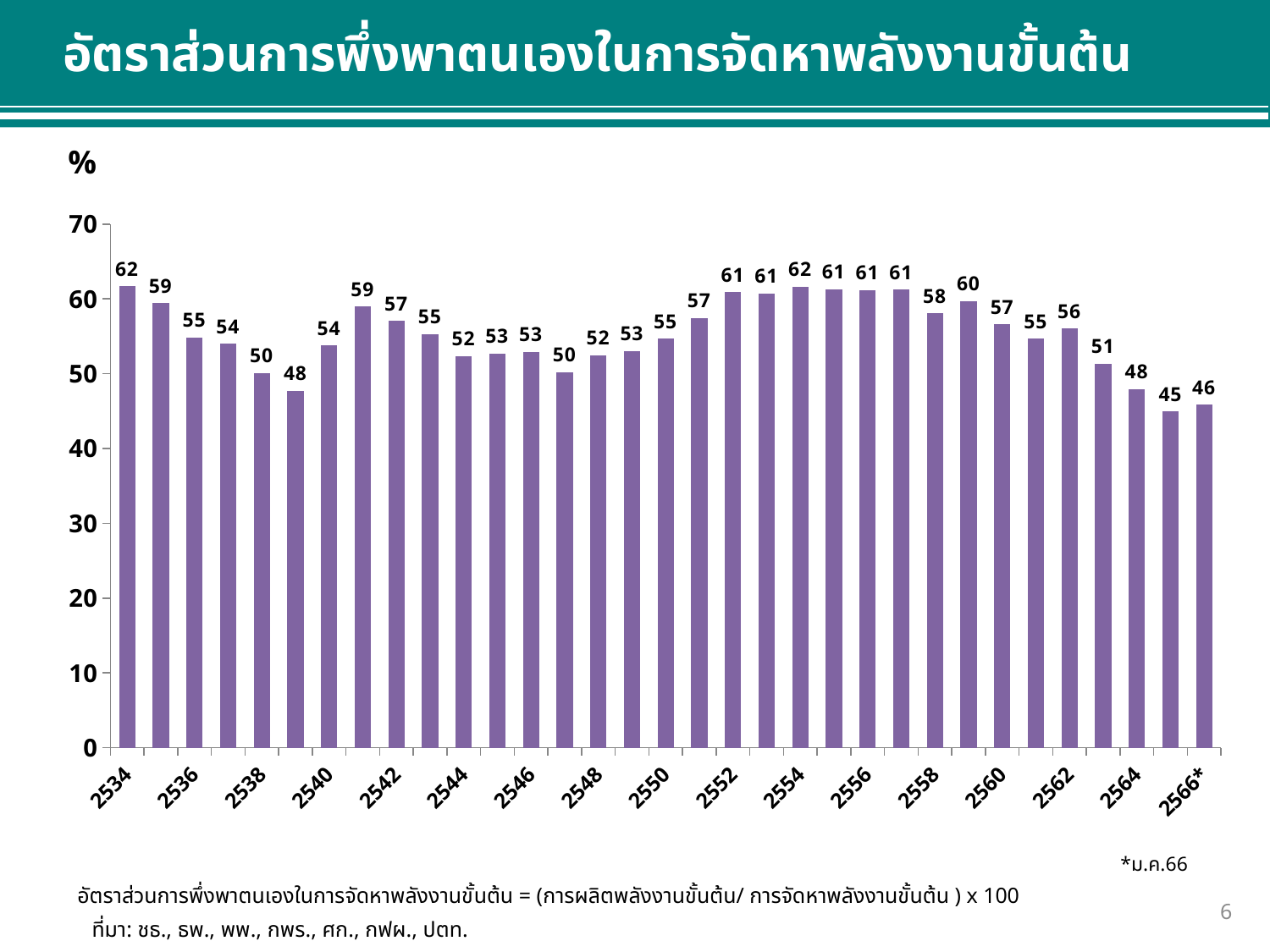
What is the value for 2534? 62 How many bars are plotted on the chart? 33 What is the value for 2566*? 46 What is the highest value shown on the chart? 62 Do the values rise or fall from 2560 to 2566*? fall Which is larger, the value for 2538 or the value for 2560? 2560 What is the difference between the value for 2534 and the value for 2566*? 16 What is the value for 2540? 54 What kind of chart is shown on the slide? bar chart What is the lowest value shown on the chart? 45 Is the value for 2564 greater or less than 50? less What is the value for 2554? 62